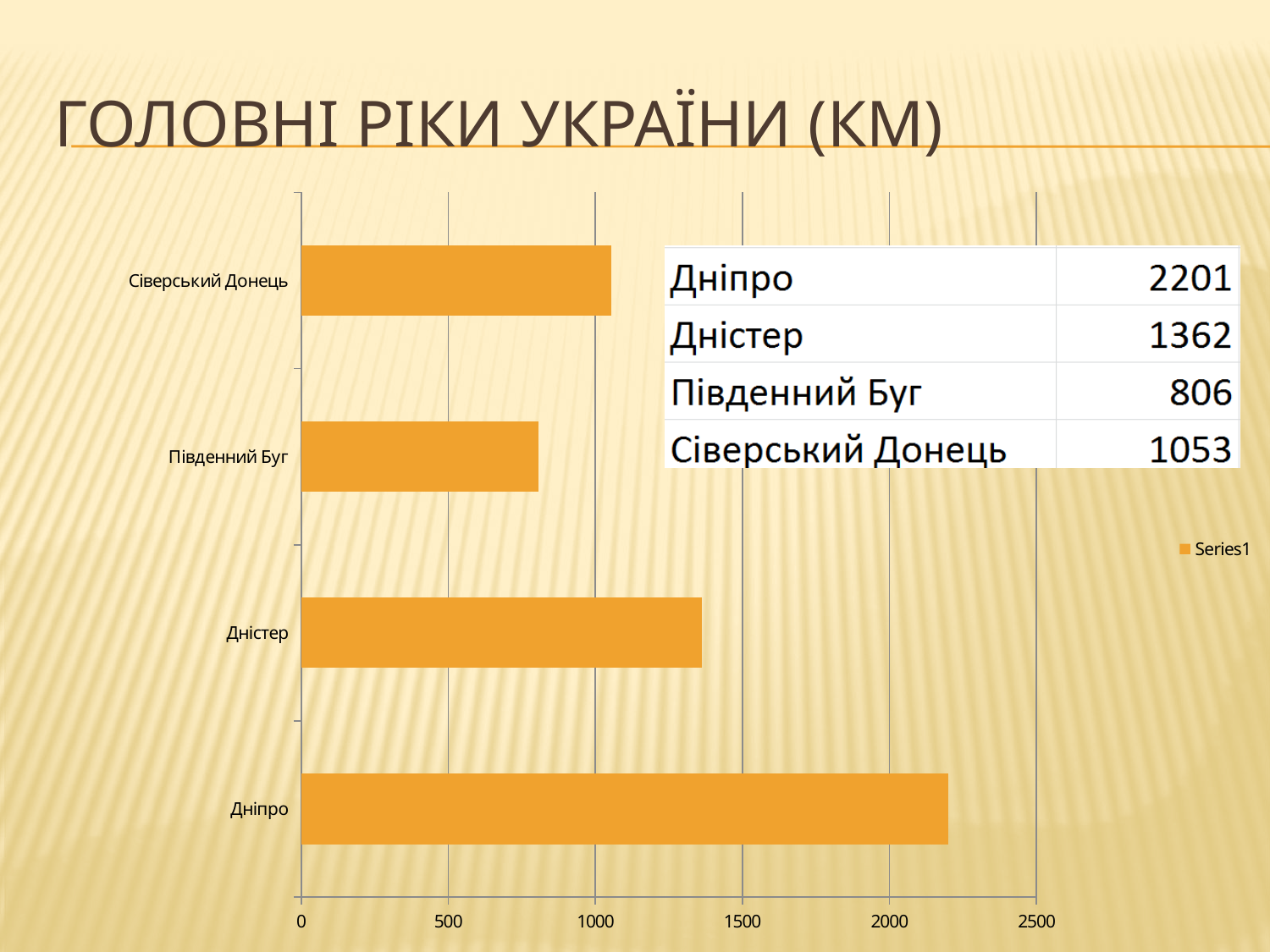
What is the value for Дніпро? 2201 What is the value for Південний Буг? 806 What is the value for Дністер? 1362 What is the difference between the values for Дніпро and Дністер? 839 What is the difference between the values for Сіверський Донець and Південний Буг? 247 What is the value for Сіверський Донець? 1053 Is the value for Сіверський Донець greater or less than 1000? greater Which is larger, the value for Дністер or the value for Сіверський Донець? Дністер How many rivers are shown in the chart? 4 What kind of chart is shown on the slide? bar chart Which river has the lowest value? Південний Буг Which river has the highest value? Дніпро